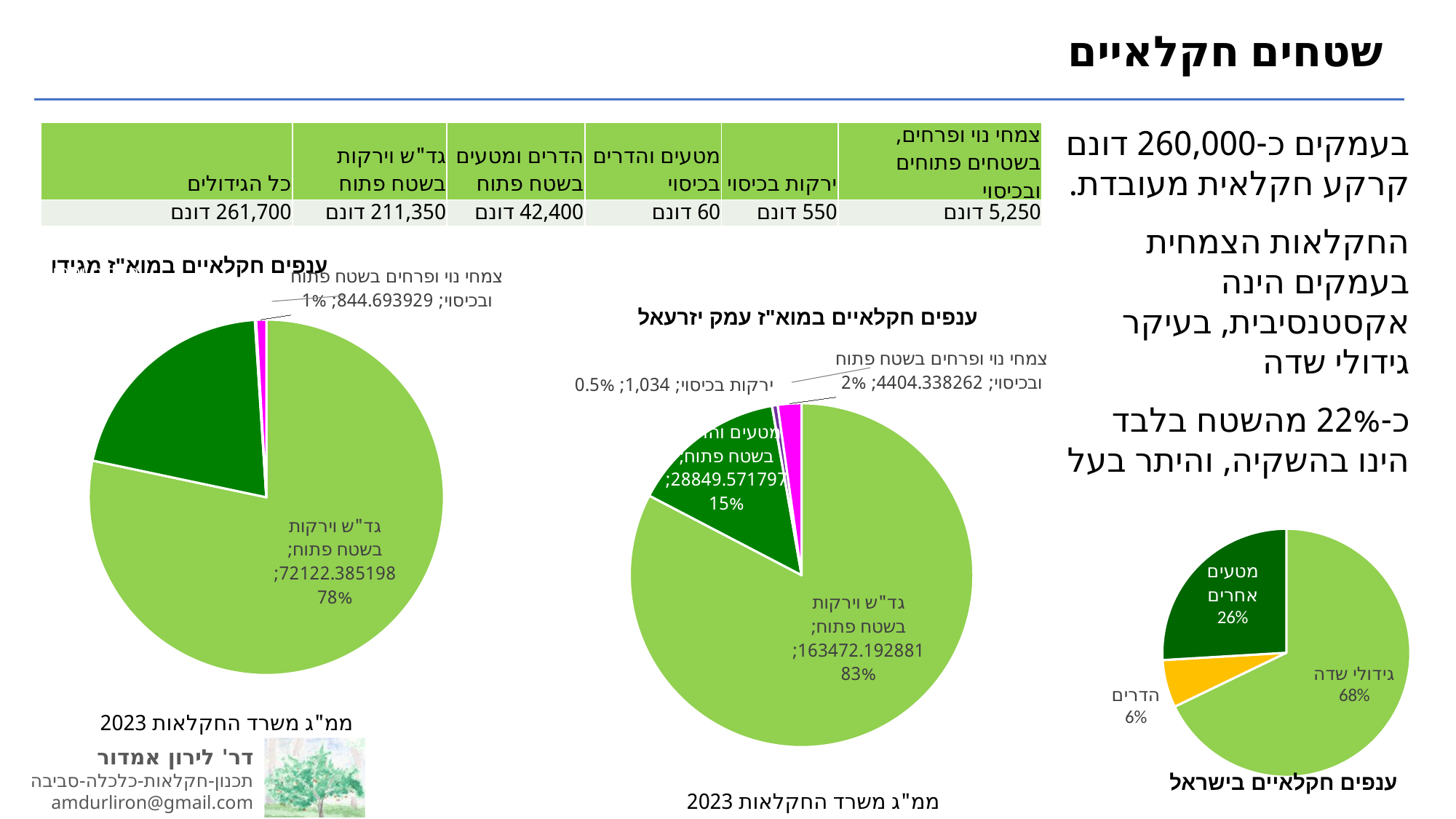
In the chart titled "ענפים חקלאיים במוא"ז מגידו", what share does "גד"ש וירקות בשטח פתוח" have? 78% In the chart titled "ענפים חקלאיים בישראל", what share does "הדרים" have? 6% In the chart titled "ענפים חקלאיים במוא"ז מגידו", what share does "צמחי נוי ופרחים בשטח פתוח ובכיסוי" have? 1% In the chart titled "ענפים חקלאיים בישראל", which category has the smallest slice? הדרים In the chart titled "ענפים חקלאיים בישראל", how many slices are there? 3 In the chart titled "ענפים חקלאיים בישראל", which category has the largest slice? גידולי שדה What kind of chart is the chart titled "ענפים חקלאיים בישראל"? pie chart In the chart titled "ענפים חקלאיים בישראל", what is the difference in percentage points between "מטעים אחרים" and "הדרים"? 20 In the chart titled "ענפים חקלאיים במוא"ז עמק יזרעאל", which category has the largest slice? גד"ש וירקות בשטח פתוח